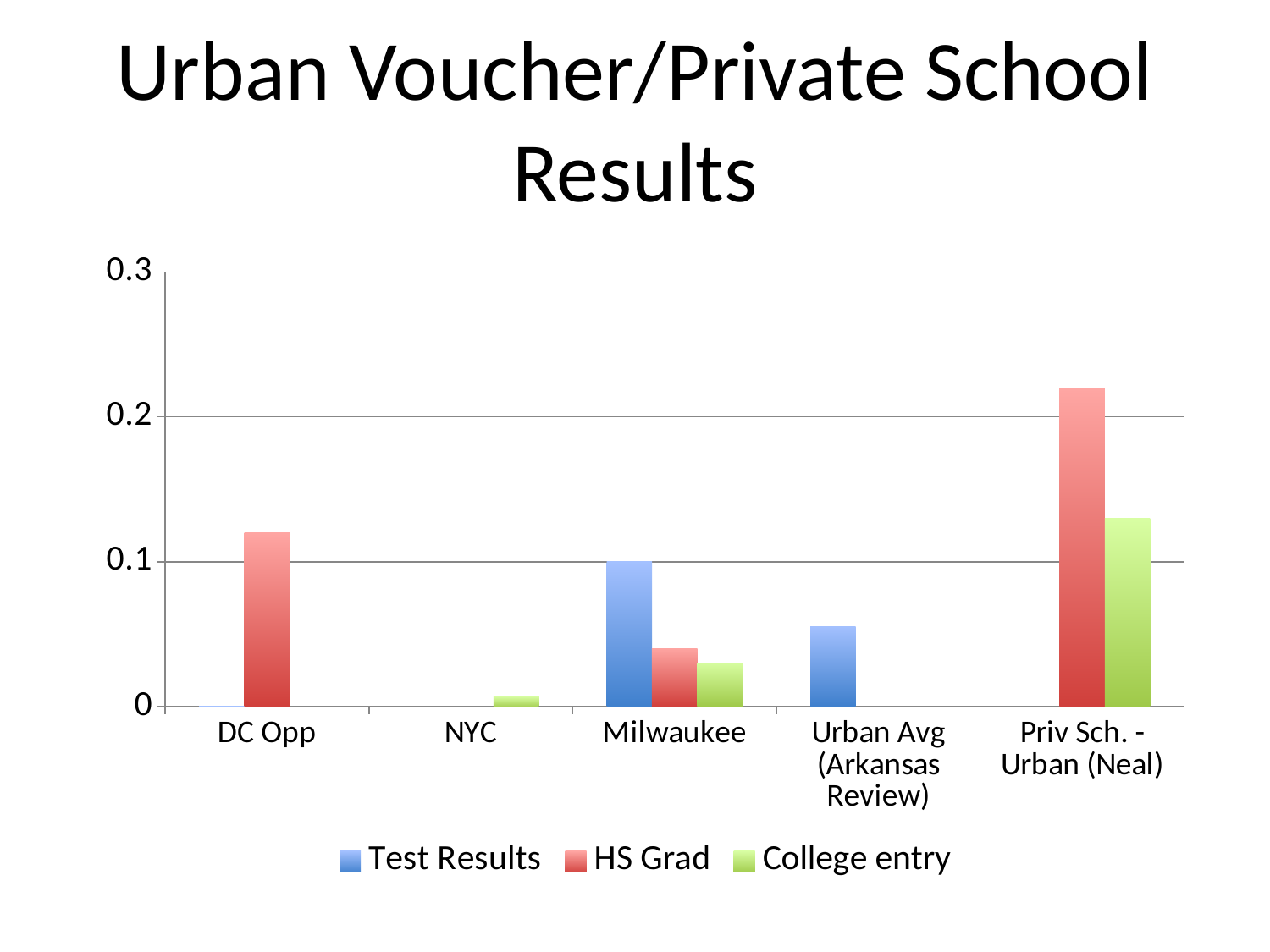
How many series does the legend list? 3 What kind of chart is shown on the slide? bar chart Is the Test Results value for Urban Avg (Arkansas Review) greater or less than 0.1? less How many categories are shown on the x axis? 5 Which is larger, the HS Grad value for DC Opp or the HS Grad value for Milwaukee? DC Opp Which category has the highest College entry value? Priv Sch. - Urban (Neal) Is the HS Grad value for Priv Sch. - Urban (Neal) greater or less than 0.2? greater Which category has the highest HS Grad value? Priv Sch. - Urban (Neal) What is the Test Results value for Milwaukee? 0.1 Which category has the highest Test Results value? Milwaukee Is the HS Grad value for DC Opp greater or less than 0.1? greater What is the title of the chart? Urban Voucher/Private School Results